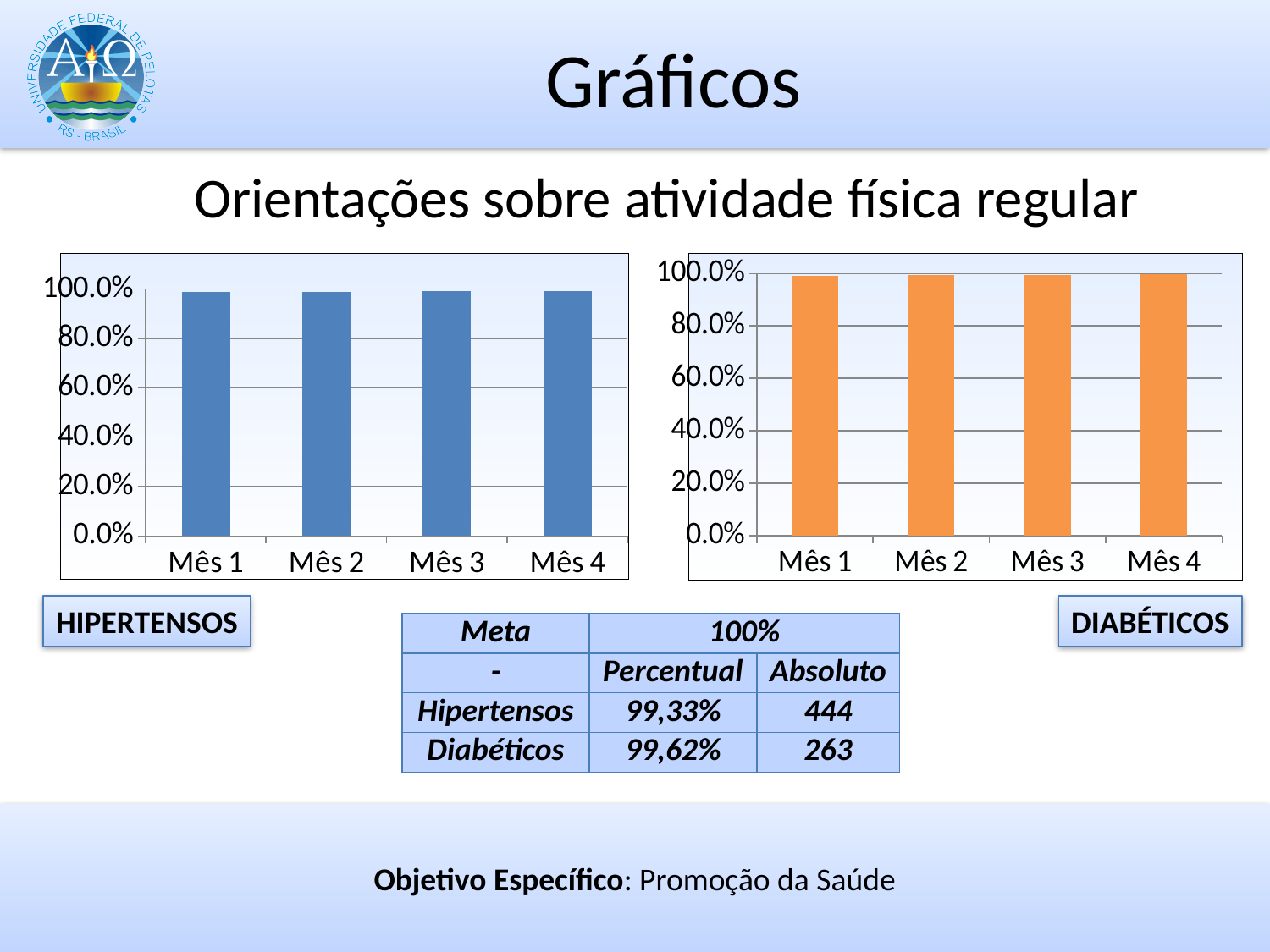
What colour are the bars in the HIPERTENSOS chart on the left? blue What is the label of the first category on the x axis of the DIABÉTICOS chart? Mês 1 In the DIABÉTICOS chart, is the value for Mês 2 greater or less than 80.0%? greater What kind of chart is the DIABÉTICOS chart on the right? bar chart In the HIPERTENSOS chart, is the value for Mês 1 greater or less than 80.0%? greater In the DIABÉTICOS chart, is the value for Mês 3 greater or less than 40.0%? greater How many bars does the DIABÉTICOS chart have? 4 How many categories are shown on the x axis of the HIPERTENSOS chart? 4 What kind of chart is the HIPERTENSOS chart on the left? bar chart